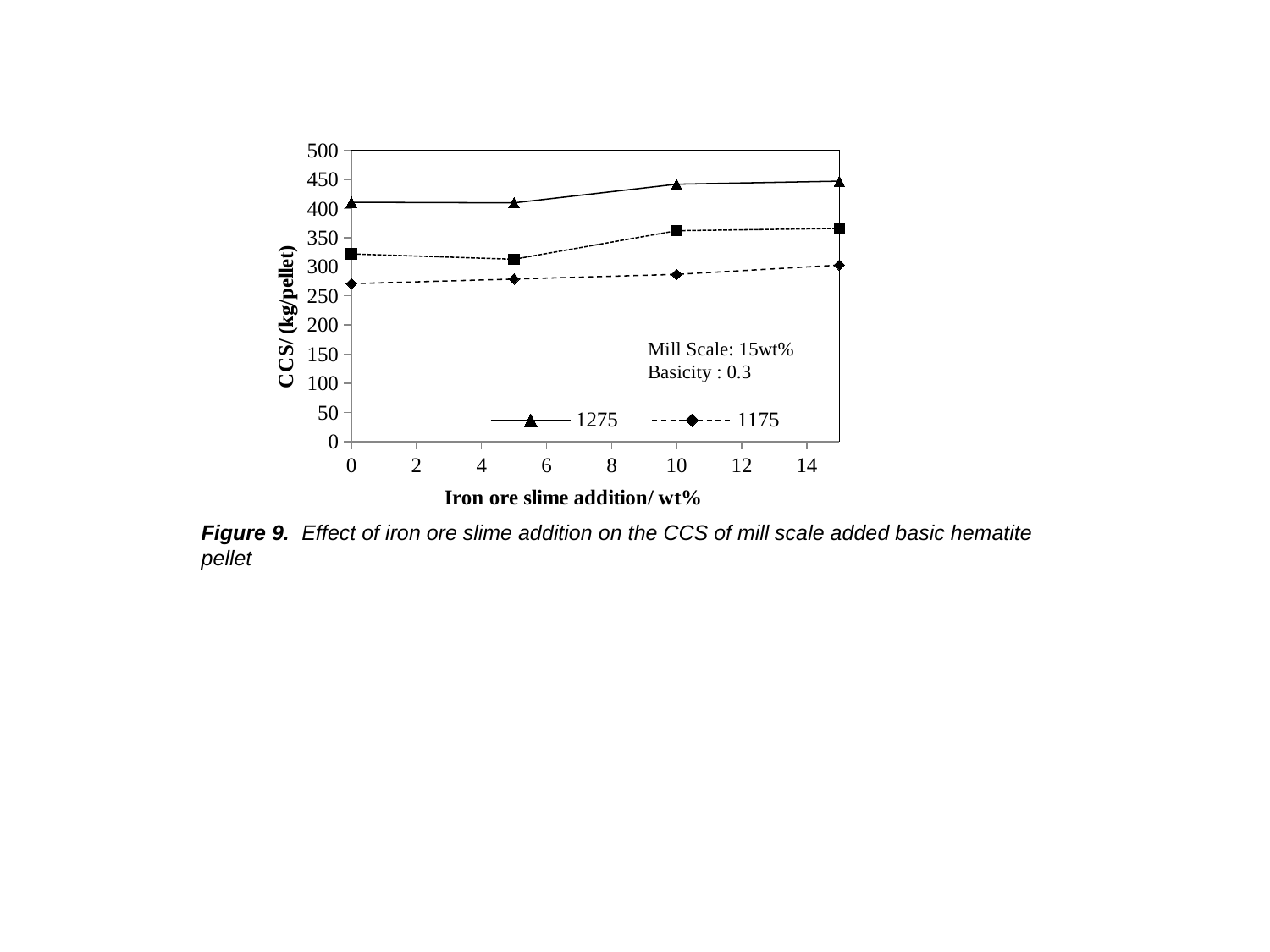
What mill scale content is stated in the annotation on the chart? 15wt% Is the value for the 1175 series at 10 wt% iron ore slime addition greater or less than 300? less Which series in the legend has the highest CCS values across all iron ore slime additions? 1275 Is the value for the 1275 series at 15 wt% iron ore slime addition greater or less than 400? greater What is the label of the y axis? CCS/ (kg/pellet) Which series has the higher CCS at 10 wt% iron ore slime addition, 1275 or 1175? 1275 Is the value for the 1175 series at 0 wt% iron ore slime addition greater or less than 300? less How many series does the legend list? 2 What kind of chart is shown on the slide? line chart How many data points are plotted for the 1275 series? 4 Do the values for the 1175 series rise or fall as iron ore slime addition increases? rise